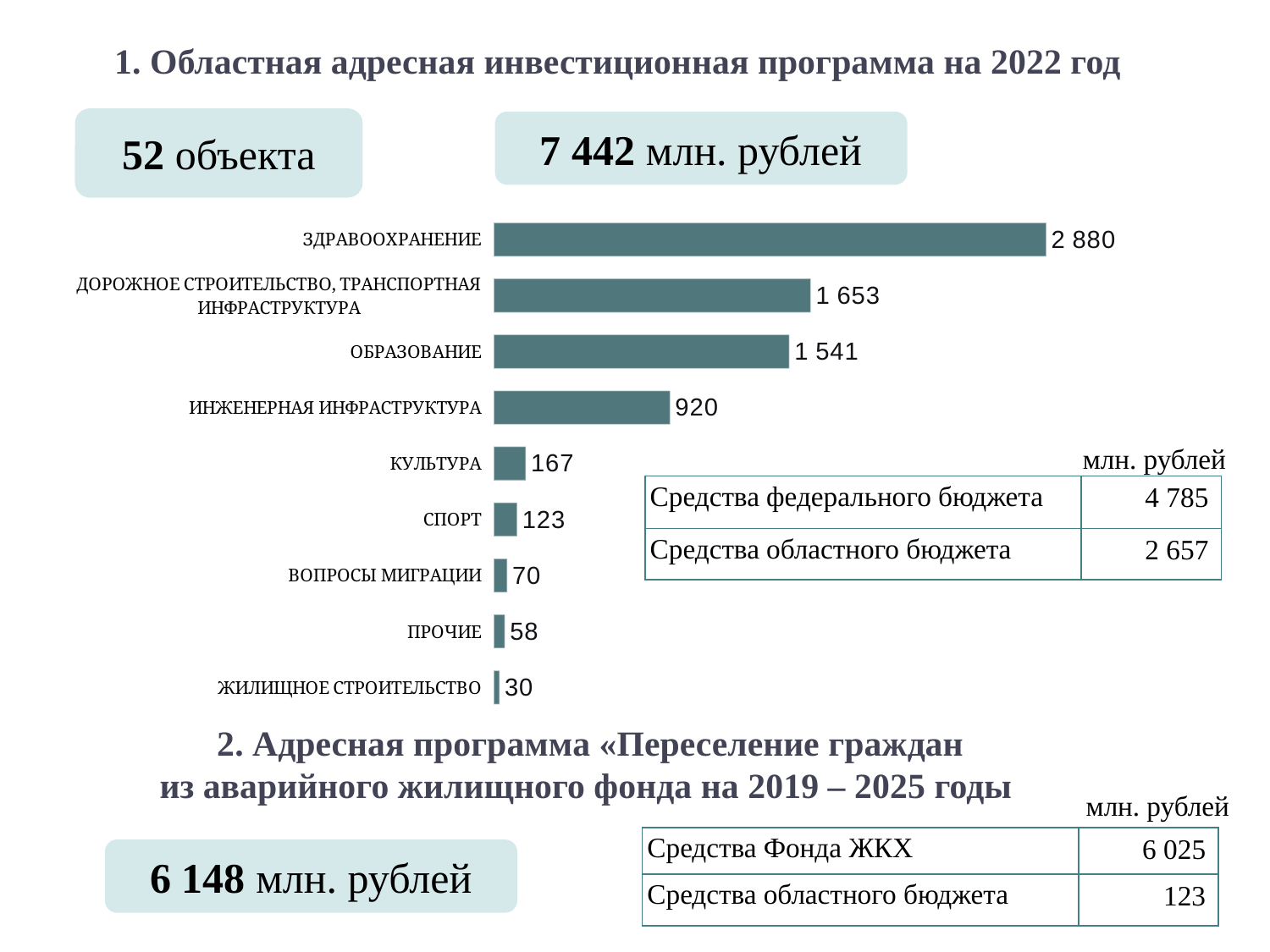
What is the value for ЗДРАВООХРАНЕНИЕ in the bar chart? 2 880 Which category has the lowest value in the bar chart? ЖИЛИЩНОЕ СТРОИТЕЛЬСТВО What is the value for ИНЖЕНЕРНАЯ ИНФРАСТРУКТУРА in the bar chart? 920 What is the value for ОБРАЗОВАНИЕ in the bar chart? 1 541 What is the difference between the values for ЗДРАВООХРАНЕНИЕ and ДОРОЖНОЕ СТРОИТЕЛЬСТВО, ТРАНСПОРТНАЯ ИНФРАСТРУКТУРА? 1 227 Which category has the highest value in the bar chart? ЗДРАВООХРАНЕНИЕ What type of chart is shown on the slide? bar chart Do the bar values increase or decrease from the top category to the bottom category? decrease How many categories does the bar chart show? 9 Which is larger in the bar chart: ПРОЧИЕ or ВОПРОСЫ МИГРАЦИИ? ВОПРОСЫ МИГРАЦИИ What is the difference between the values for КУЛЬТУРА and СПОРТ? 44 What is the value for ВОПРОСЫ МИГРАЦИИ in the bar chart? 70